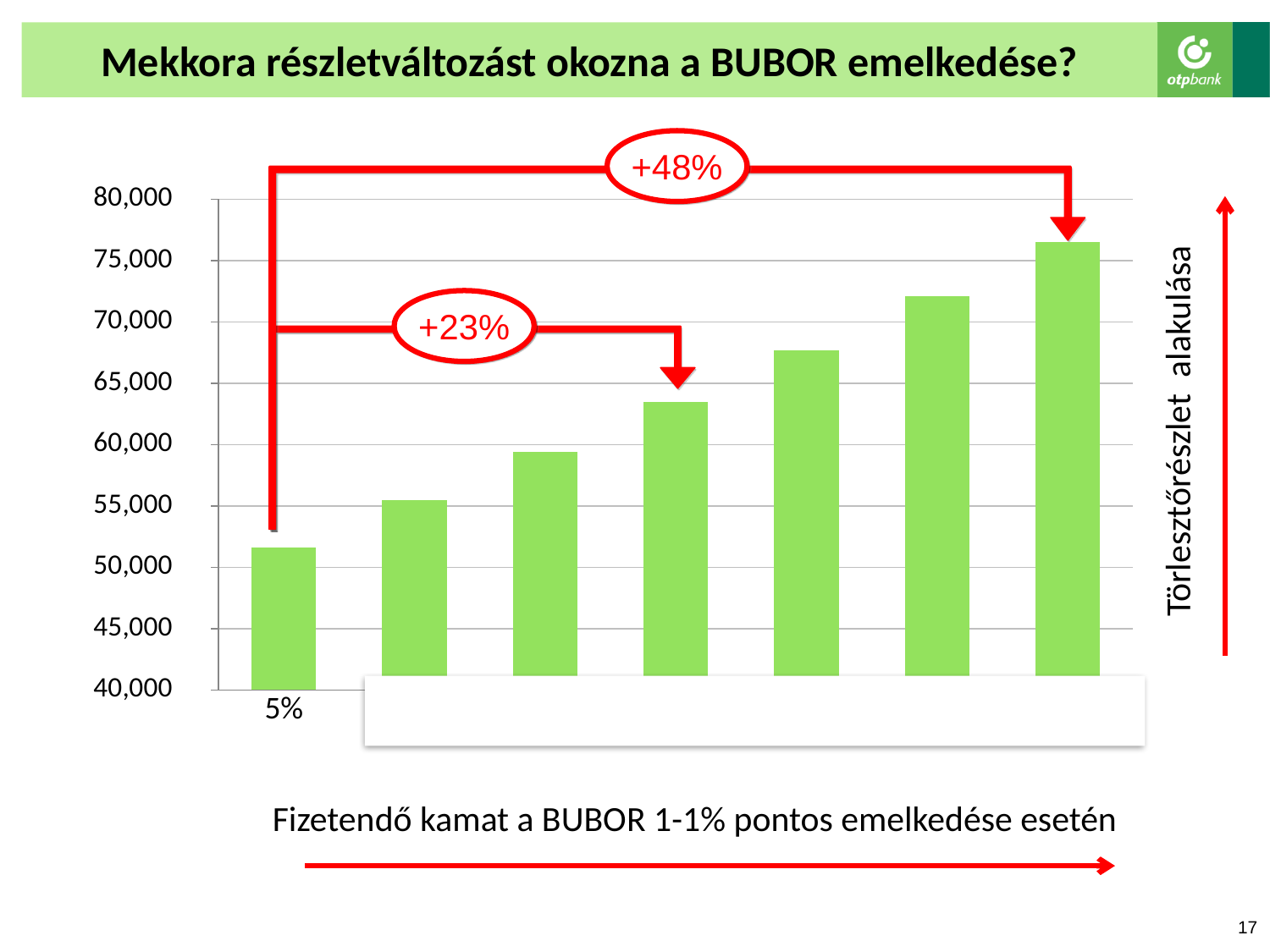
What kind of chart is shown on the slide? bar chart Do the bar values rise or fall from left to right along the x axis? rise Which is larger, the value of the 5% bar or the value of the second bar from the left? the second bar from the left Is the value for the 5% category greater or less than 55,000? less How many bars are plotted in the chart? 7 Is the value of the rightmost bar greater or less than 75,000? greater Is the value for the 5% category greater or less than 50,000? greater Which bar has the lowest value? 5% What percentage increase is shown in the upper red annotation between the first and the last bar? +48% What is the label written along the vertical red arrow on the right side of the chart? Törlesztőrészlet alakulása Which bar has the highest value, the leftmost or the rightmost? the rightmost